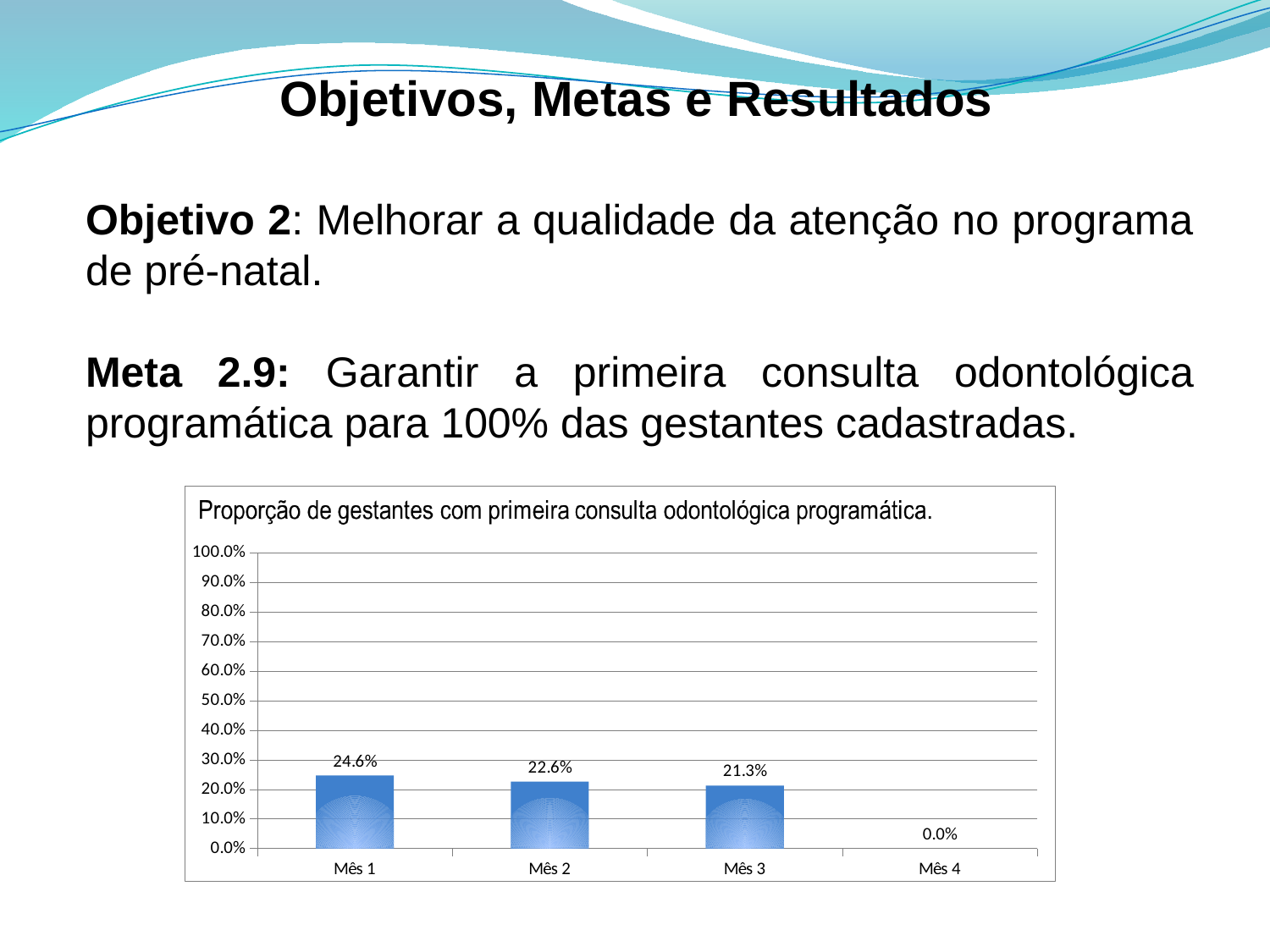
What is the value for Mês 4? 0.0% How many months are shown on the x axis? 4 Which month has the lowest value? Mês 4 What kind of chart is shown? bar chart Do the values rise or fall from Mês 1 to Mês 4? fall What is the difference between the values for Mês 1 and Mês 3? 3.3% Which month has the highest value? Mês 1 Which is larger, the value for Mês 2 or the value for Mês 3? Mês 2 What is the value for Mês 2? 22.6% What is the value for Mês 3? 21.3% Is the value for Mês 1 greater or less than 30.0%? less What is the value for Mês 1? 24.6%